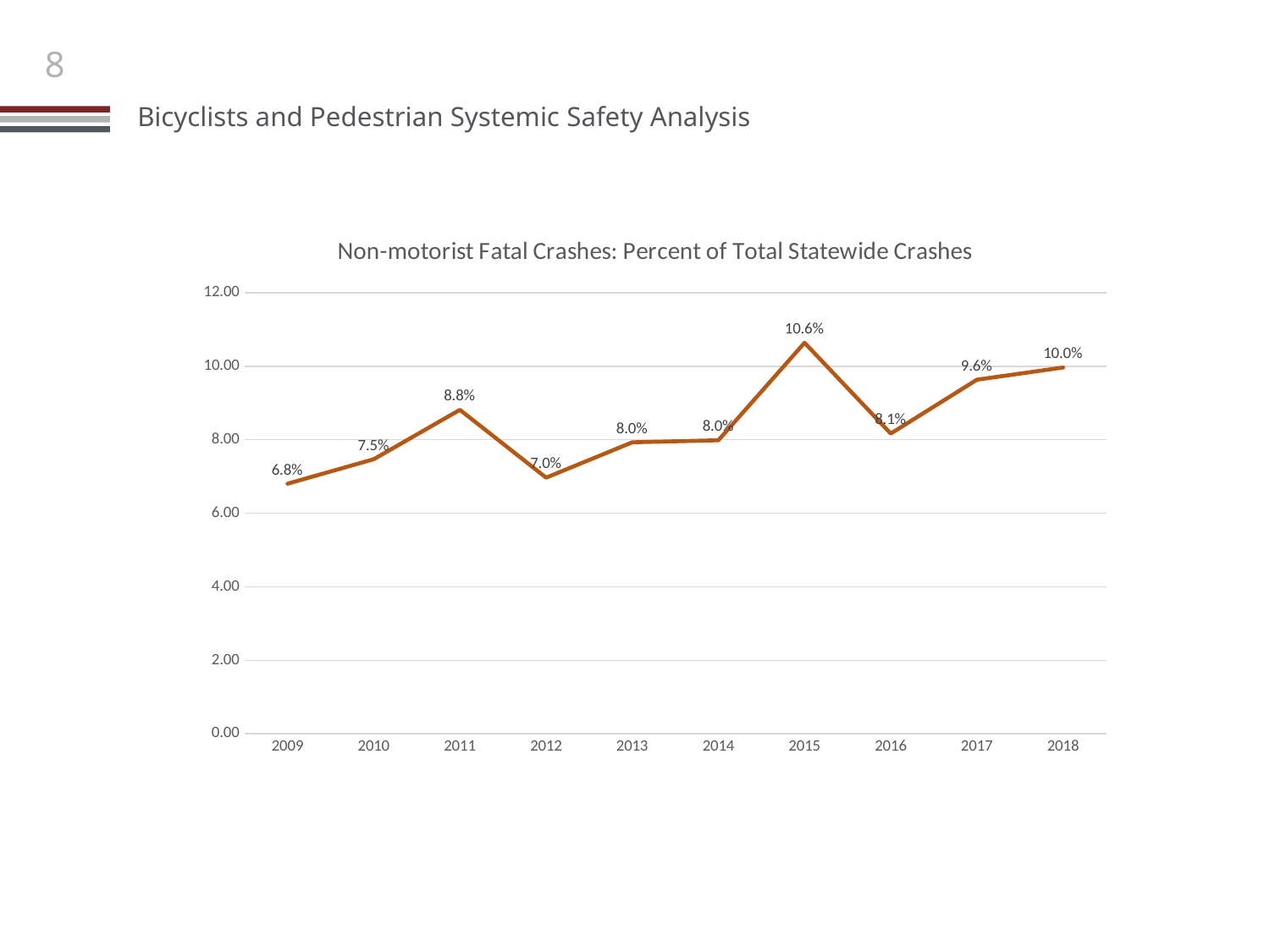
Is the value for 2018 greater or less than 8.00? greater What is the value for 2017? 9.6% What is the value for 2015? 10.6% What is the difference between the values for 2015 and 2016? 2.5% What is the title of the chart? Non-motorist Fatal Crashes: Percent of Total Statewide Crashes What is the difference between the values for 2011 and 2012? 1.8% What is the value for 2009? 6.8% Which year has the lowest value? 2009 How many years are plotted on the x axis? 10 Which year has the highest value? 2015 What kind of chart is this? line chart Which is larger, the value for 2011 or the value for 2013? 2011